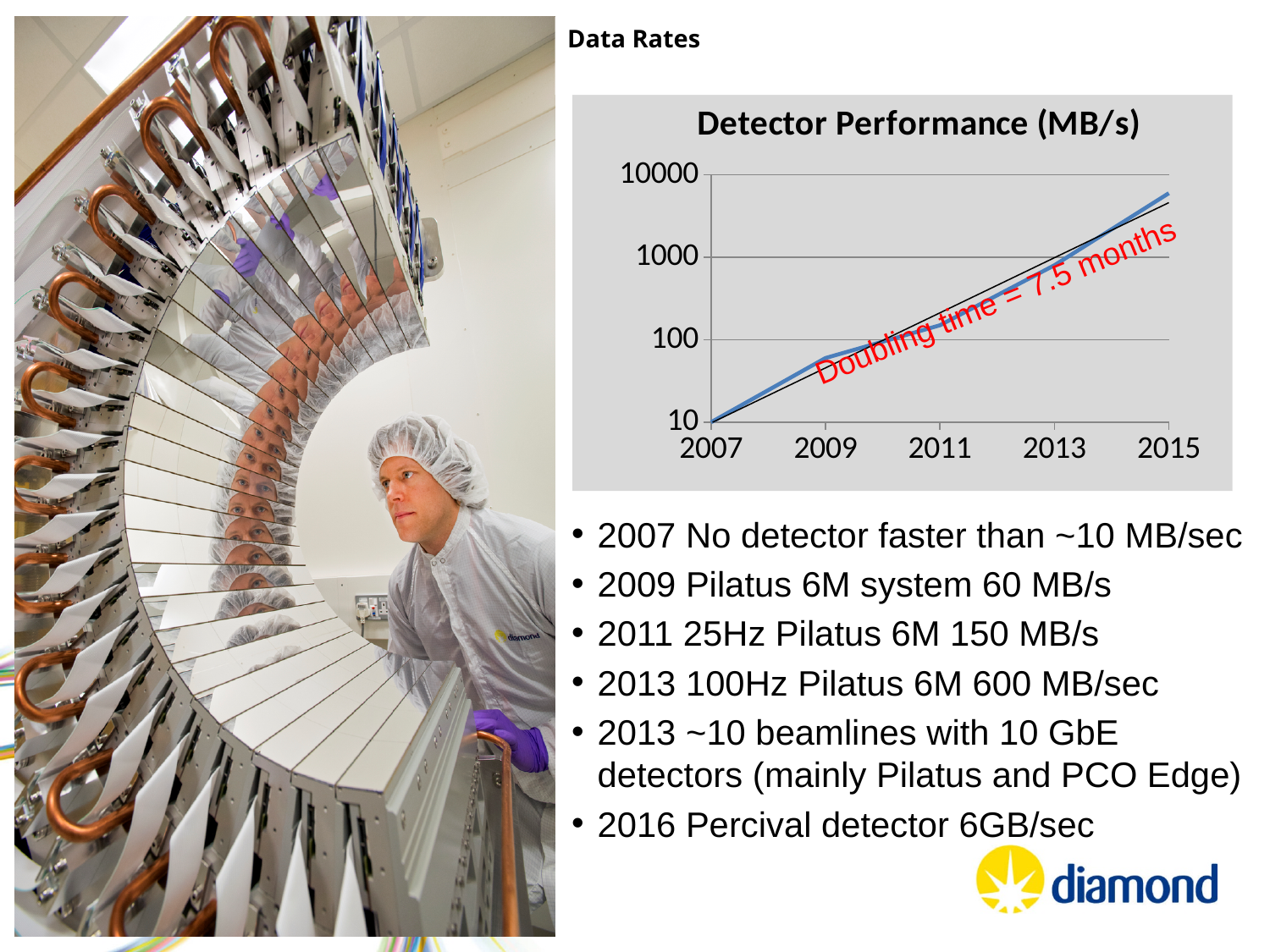
Is the value for 2011 greater or less than 100? greater How many year labels are shown on the x axis? 5 Is the value for 2009 greater or less than 100? less Is the value for 2015 greater or less than 10000? less What type of chart is shown on the slide? line chart Which year shown on the x axis has the lowest value? 2007 Which year shown on the x axis has the highest value? 2015 What is the title of the chart? Detector Performance (MB/s) Do the values in the chart rise or fall from 2007 to 2015? rise What doubling time is annotated on the chart? 7.5 months